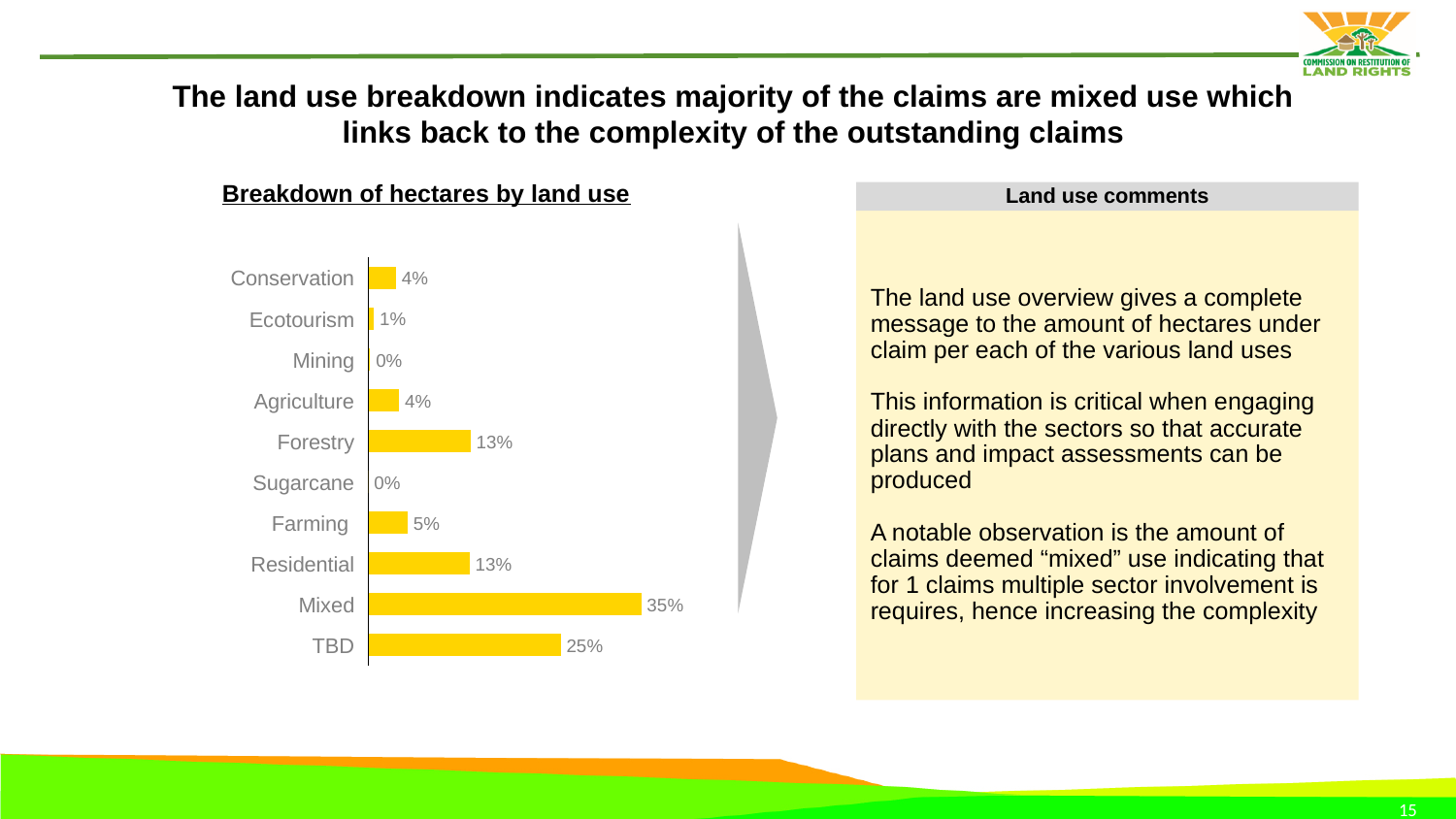
How many land use categories are shown in the chart? 10 What percentage of hectares is shown for Forestry? 13% Which has a larger share of hectares, Conservation or Ecotourism? Conservation What is the difference in percentage points between Mixed and TBD? 10 What percentage of hectares is shown for TBD? 25% What percentage of hectares is shown for Ecotourism? 1% What is the difference in percentage points between Forestry and Farming? 8 Which land use category has the highest share of hectares? Mixed What percentage of hectares is shown for Mixed land use? 35% Which has a larger share of hectares, Residential or Farming? Residential What is the title of the chart on the slide? Breakdown of hectares by land use What type of chart is used to show the breakdown of hectares by land use? Bar chart